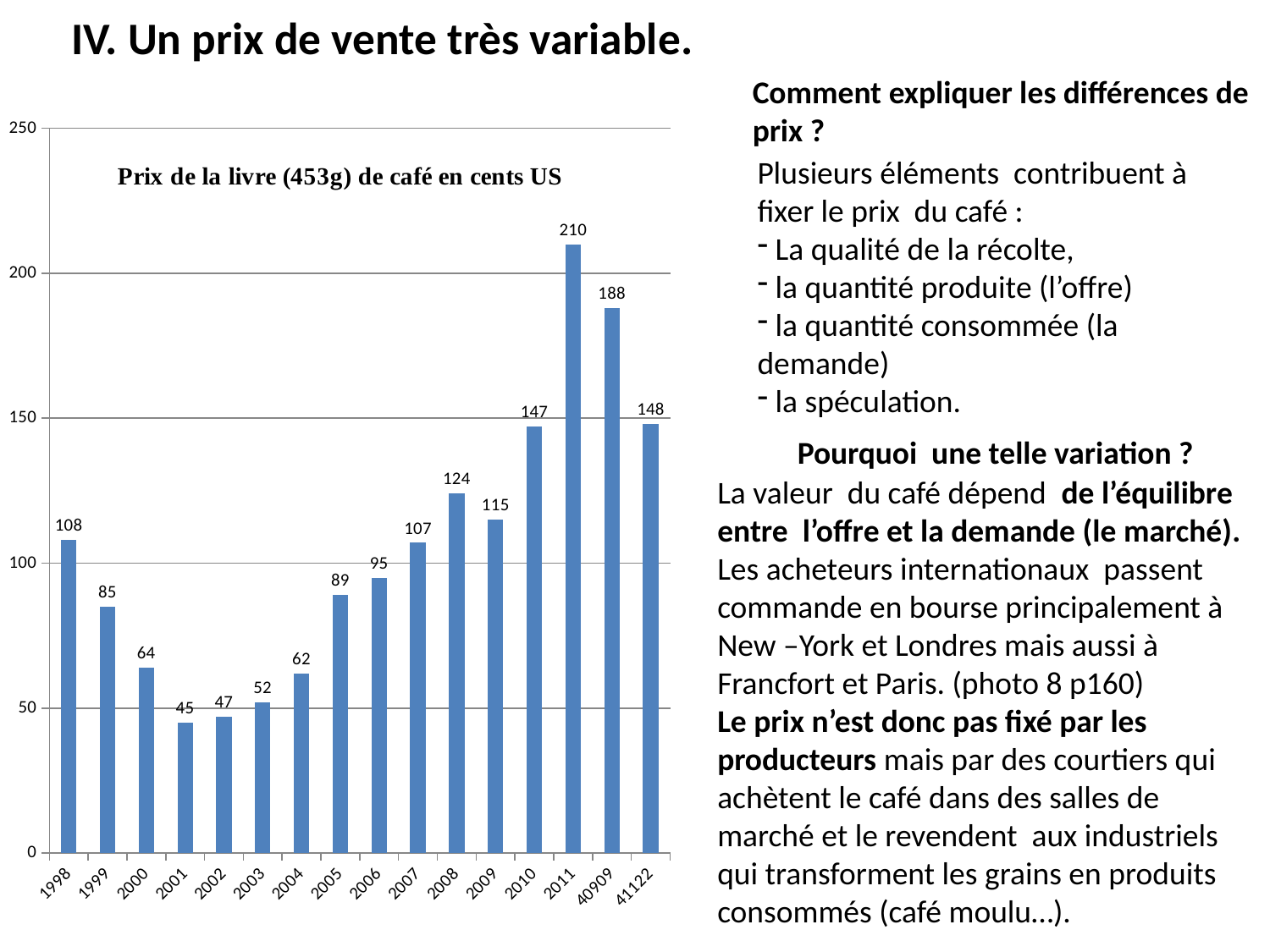
What is the difference between the values for 2011 and 2001? 165 What is the difference between the values for 1998 and 1999? 23 What is the title of the chart? Prix de la livre (453g) de café en cents US Which year has the lowest value on the chart? 2001 Which is larger, the value for 2007 or the value for 2009? 2009 What value is shown for 2008 on the chart? 124 How many bars are plotted on the chart? 16 Which year has the highest value on the chart? 2011 What value is shown for 2001 on the chart? 45 What kind of chart is shown on the slide? bar chart What is the price of a pound of coffee in 2011 according to the chart? 210 Is the value for 2010 greater or less than 100? greater